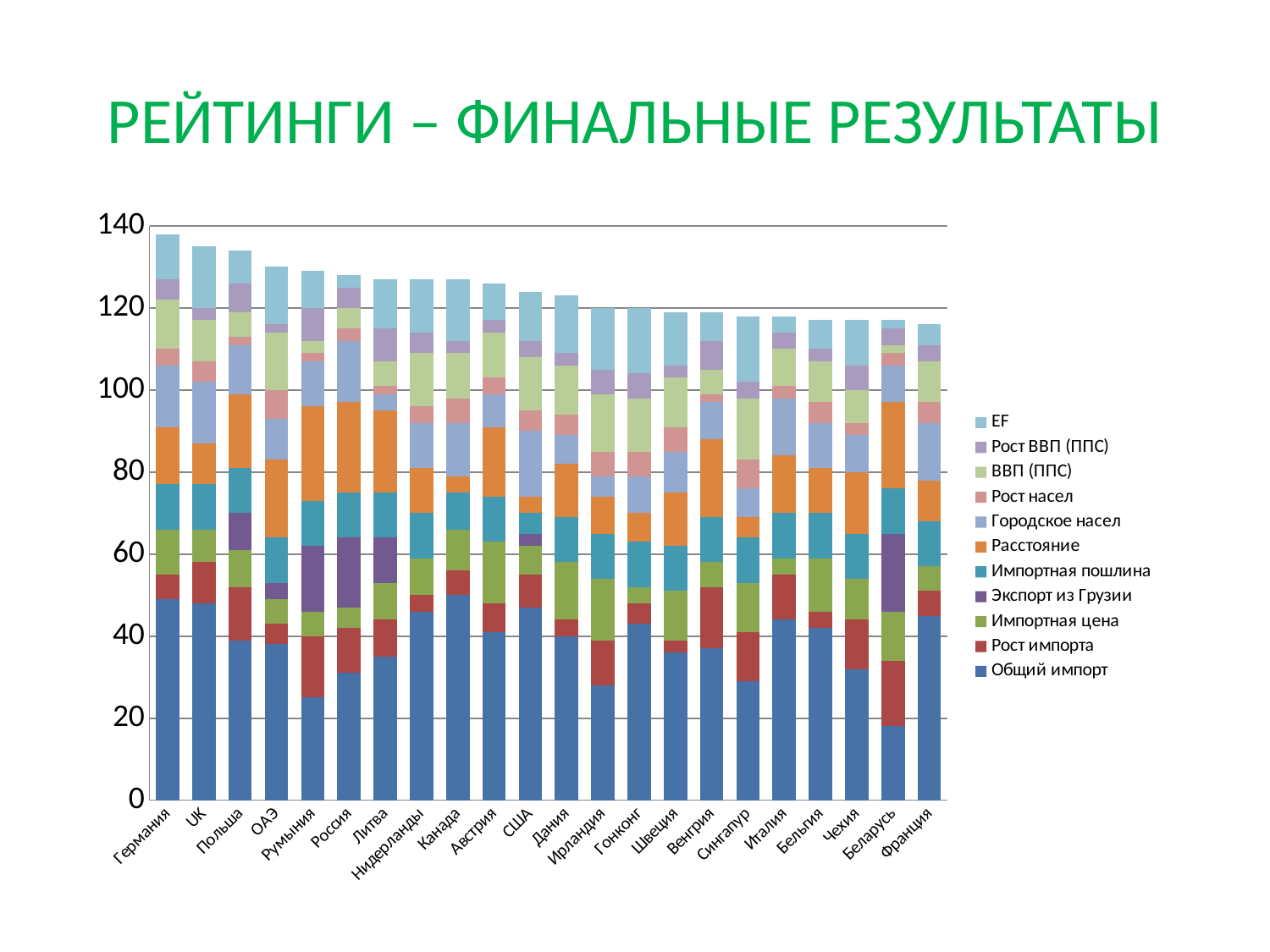
What kind of chart is shown on the slide? Stacked bar chart Is the total stacked value for Франция greater or less than 120? less How many countries (categories) are shown on the x axis? 22 Do the total stacked values rise or fall moving from left to right along the x axis? Fall What is the title of the slide? РЕЙТИНГИ – ФИНАЛЬНЫЕ РЕЗУЛЬТАТЫ How many series does the legend list? 11 Is the Общий импорт value for Ирландия greater or less than 40? less Which country has the highest total stacked bar? Германия Which has the larger total stacked bar, Германия or Франция? Германия Which country has the lowest value for the Общий импорт series? Беларусь Is the total stacked value for Германия greater or less than 120? greater